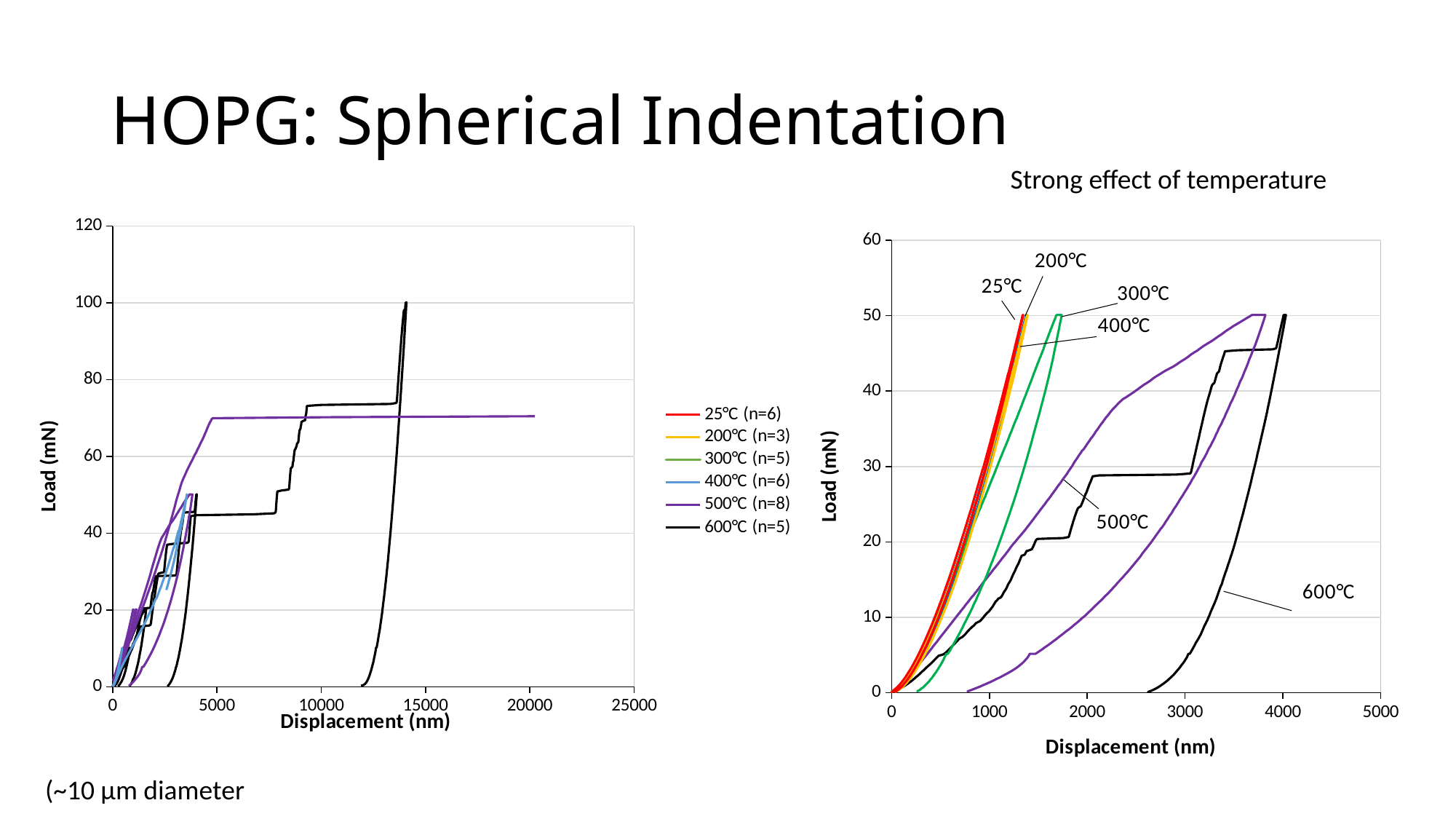
On the right chart, which temperature curve reaches the largest displacement? 600°C What kind of chart is the left chart? line chart How many series does the legend of the left chart list? 6 On the left chart, is the plateau load of the 500°C curve greater or less than 60 mN? greater On the left chart, which series reaches the highest load? 600°C (n=5) On the right chart, what is the maximum load reached by the curves? 50 mN On the left chart, how many tests (n) does the legend give for the 500°C series? n=8 On the right chart, is the maximum displacement of the 600°C curve greater or less than 3000 nm? greater On the right chart, is the maximum displacement of the 25°C curve greater or less than 2000 nm? less On the left chart, what is the maximum load reached by the 600°C curve? 100 mN On the left chart, what is the label of the y axis? Load (mN) On the left chart, which series extends to the largest displacement? 500°C (n=8)